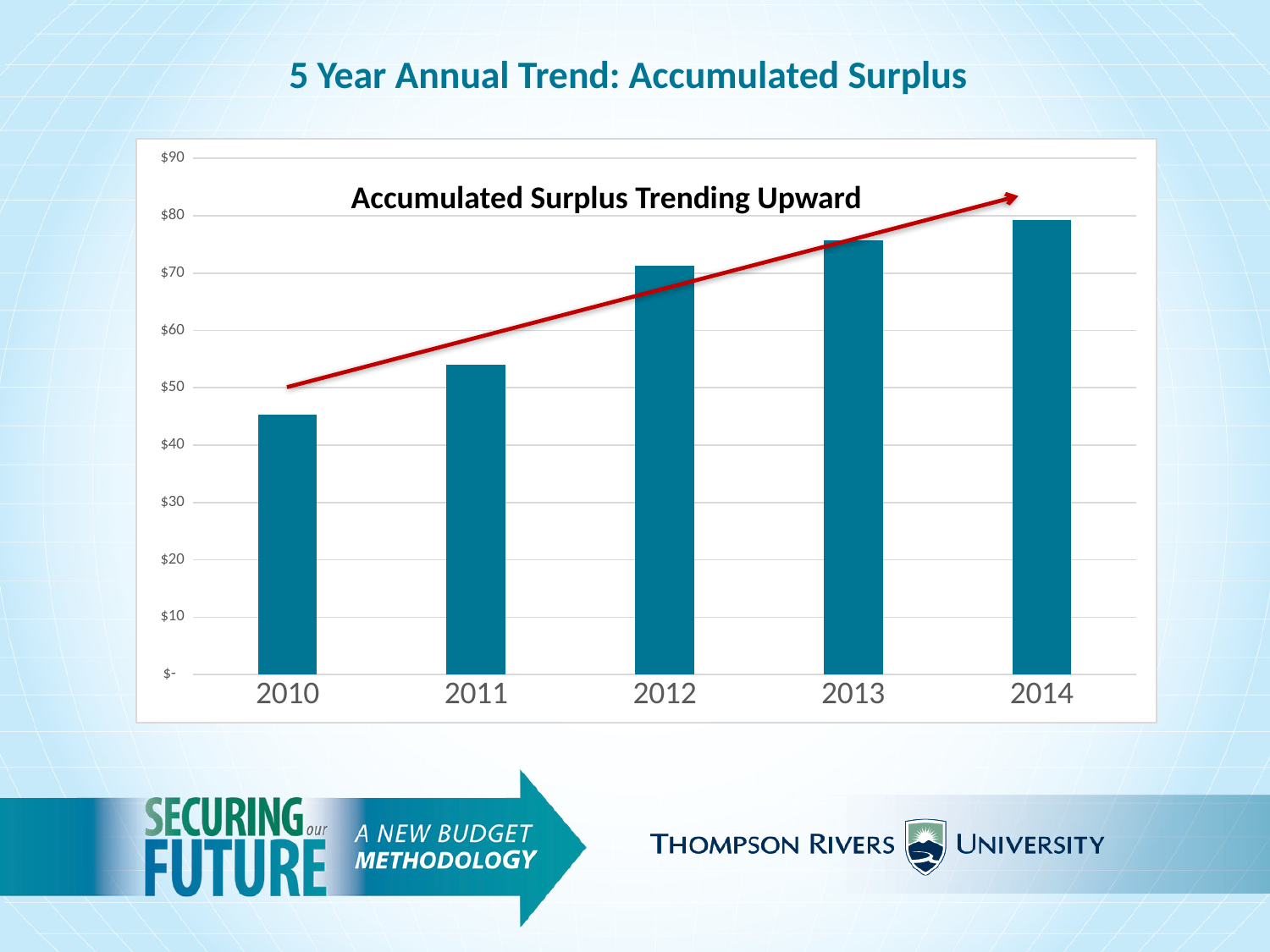
Is the value for 2012 greater or less than $60? greater What text is written inside the chart above the bars? Accumulated Surplus Trending Upward What kind of chart is shown on the slide? bar chart Do the accumulated surplus values rise or fall from 2010 to 2014? rise Which year has the larger accumulated surplus, 2011 or 2012? 2012 Is the value for 2013 greater or less than $70? greater Which year has the highest accumulated surplus? 2014 Is the value for 2014 greater or less than $70? greater Which year has the lowest accumulated surplus? 2010 How many years are plotted on the chart? 5